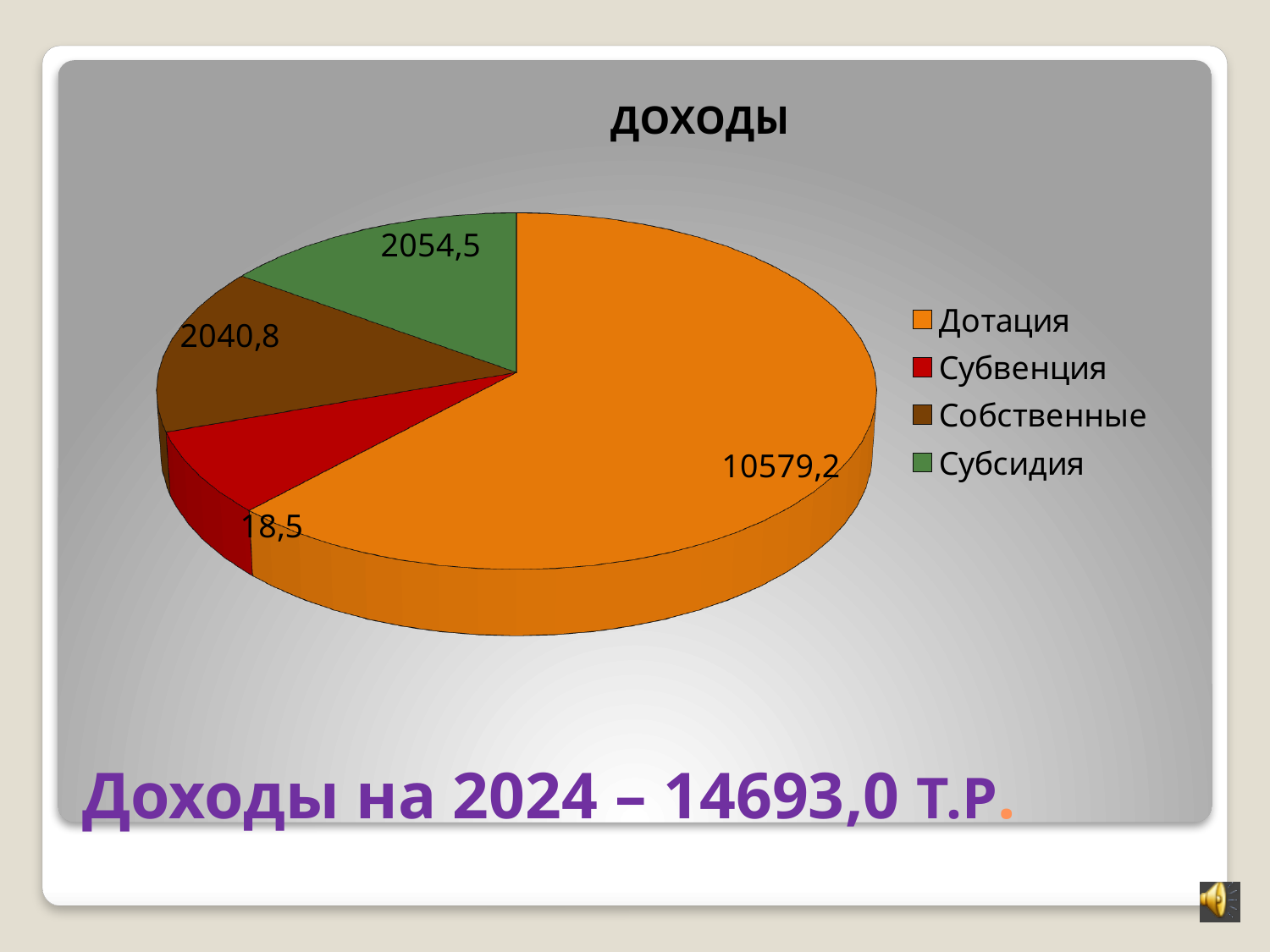
What is the value for Субсидия? 2054,5 What is the value for Дотация? 10579,2 Which category has the smallest slice of the pie? Субвенция What is the value for Субвенция? 18,5 Which category has the largest slice of the pie? Дотация What is the value for Собственные? 2040,8 What is the difference between the values for Субсидия and Собственные? 13,7 What colour is the slice for Собственные? brown Which is larger, the value for Дотация or the value for Субсидия? Дотация How many categories does the pie chart have? 4 What kind of chart is shown on the slide? pie chart What is the title of the chart? доходы